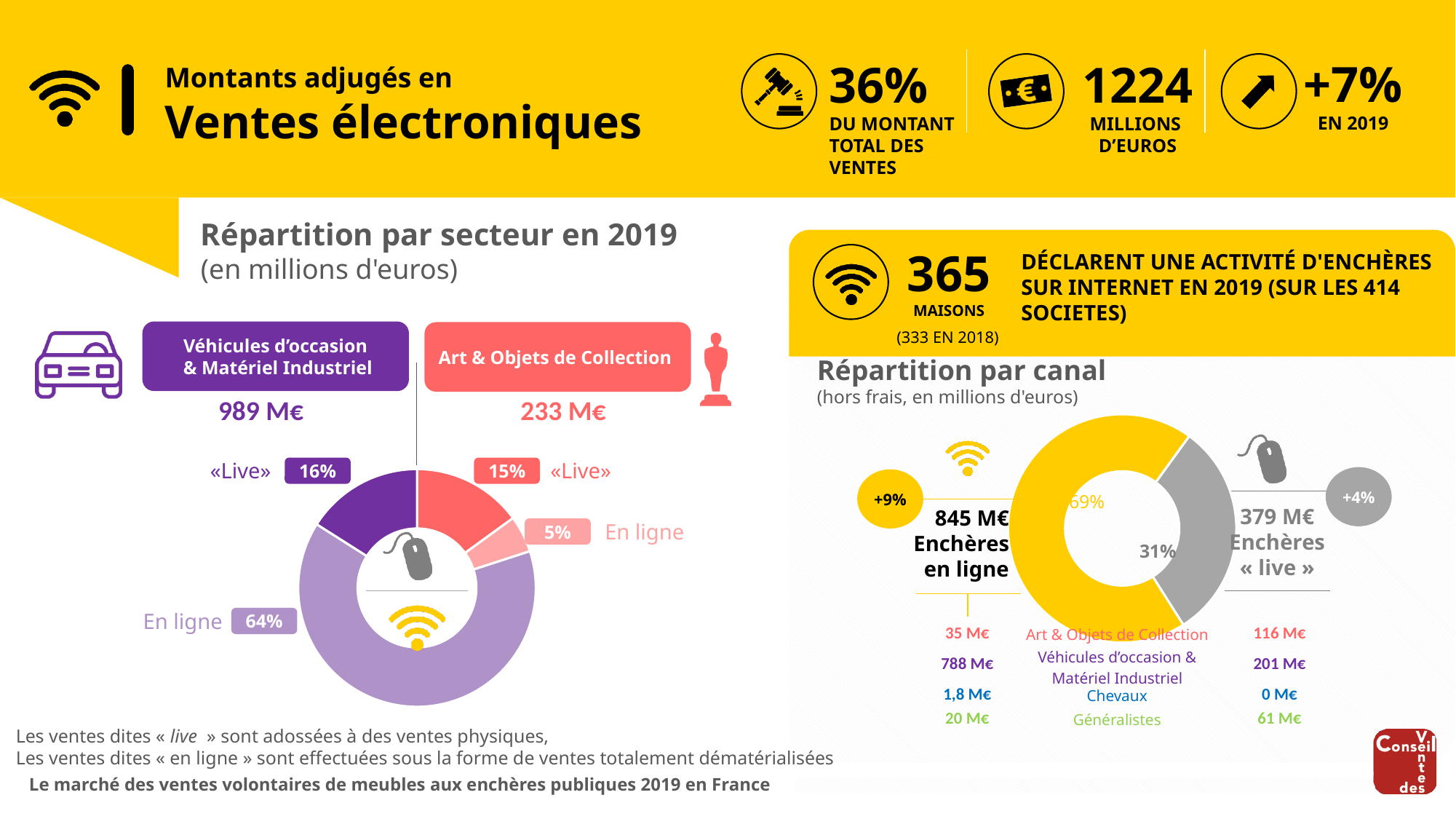
In the 'Répartition par canal' chart, what is the 'Enchères en ligne' amount for Véhicules d'occasion & Matériel Industriel? 788 M€ What type of chart is used for 'Répartition par canal'? Donut (pie) chart In the 'Répartition par secteur en 2019' chart, which segment has the smallest share? En ligne (Art & Objets de Collection), 5% In the 'Répartition par canal' chart, how many segments does the donut have? 2 In the 'Répartition par secteur en 2019' chart, what is the total amount shown for Véhicules d'occasion & Matériel Industriel? 989 M€ In the 'Répartition par canal' chart, what share is shown for 'Enchères en ligne'? 69% In the 'Répartition par canal' chart, what amount is shown for 'Enchères « live »'? 379 M€ In the 'Répartition par secteur en 2019' chart, what share is labelled for 'En ligne' in the Véhicules d'occasion & Matériel Industriel sector? 64% In the 'Répartition par secteur en 2019' chart, what share is labelled for '«Live»' in the Art & Objets de Collection sector? 15% In the 'Répartition par secteur en 2019' chart, what is the difference in percentage points between the '«Live»' shares of the two sectors (16% and 15%)? 1 percentage point In the 'Répartition par canal' chart, which is larger: Enchères en ligne or Enchères « live »? Enchères en ligne In the 'Répartition par secteur en 2019' chart, which segment has the largest share? En ligne (Véhicules d'occasion & Matériel Industriel), 64%